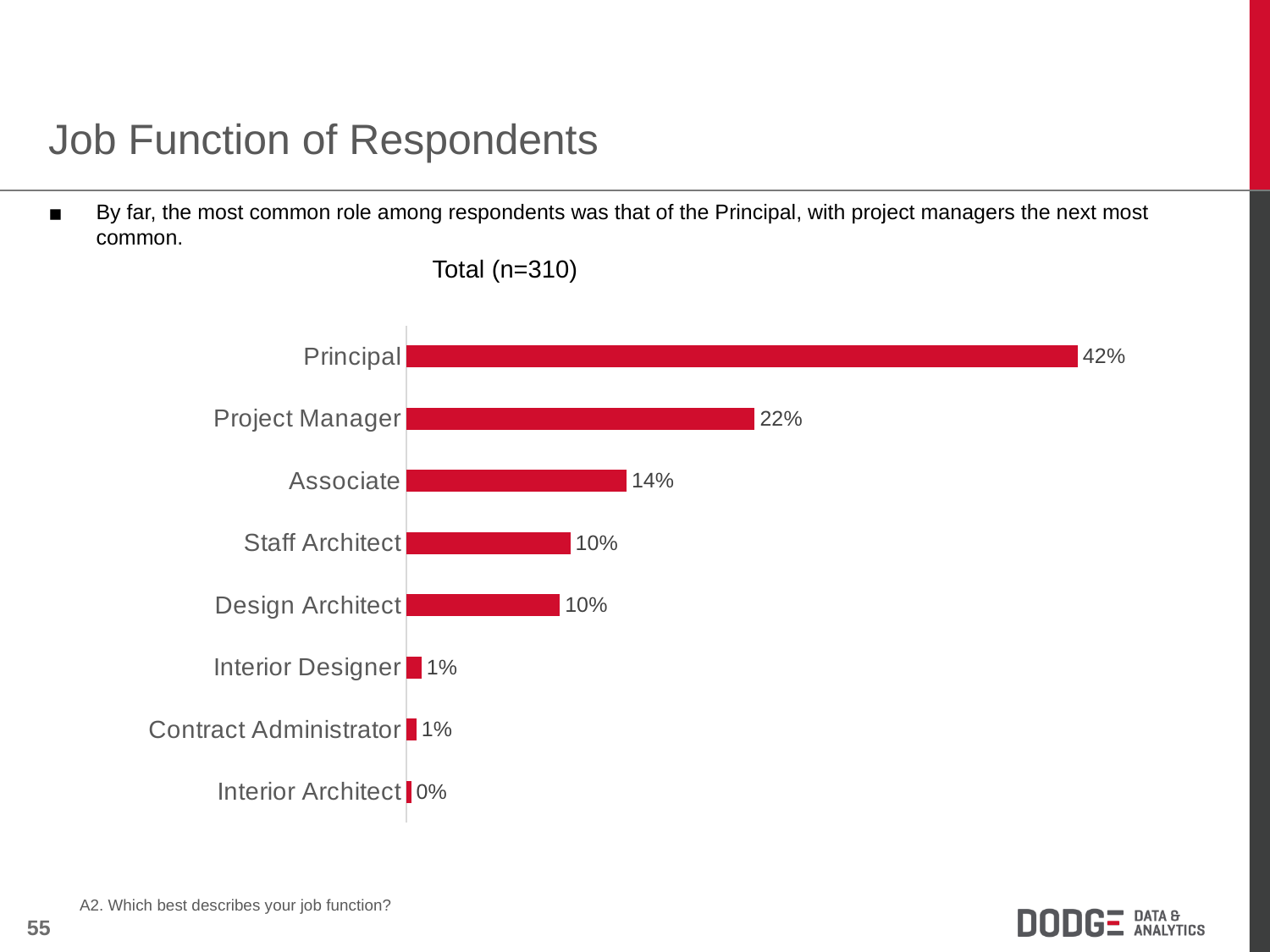
Which is larger, the value for Project Manager or the value for Associate? Project Manager What is the difference between the Associate and Staff Architect values? 4% Which job function has the lowest share of respondents? Interior Architect What is the value for Project Manager? 22% How many job function categories are shown in the chart? 8 What is the value for Interior Architect? 0% Which job function has the highest share of respondents? Principal What is the title shown above the chart? Total (n=310) What is the difference between the Principal and Project Manager values? 20% What percentage of respondents are Associates? 14% What type of chart is shown on the slide? Bar chart What percentage of respondents are Principals? 42%